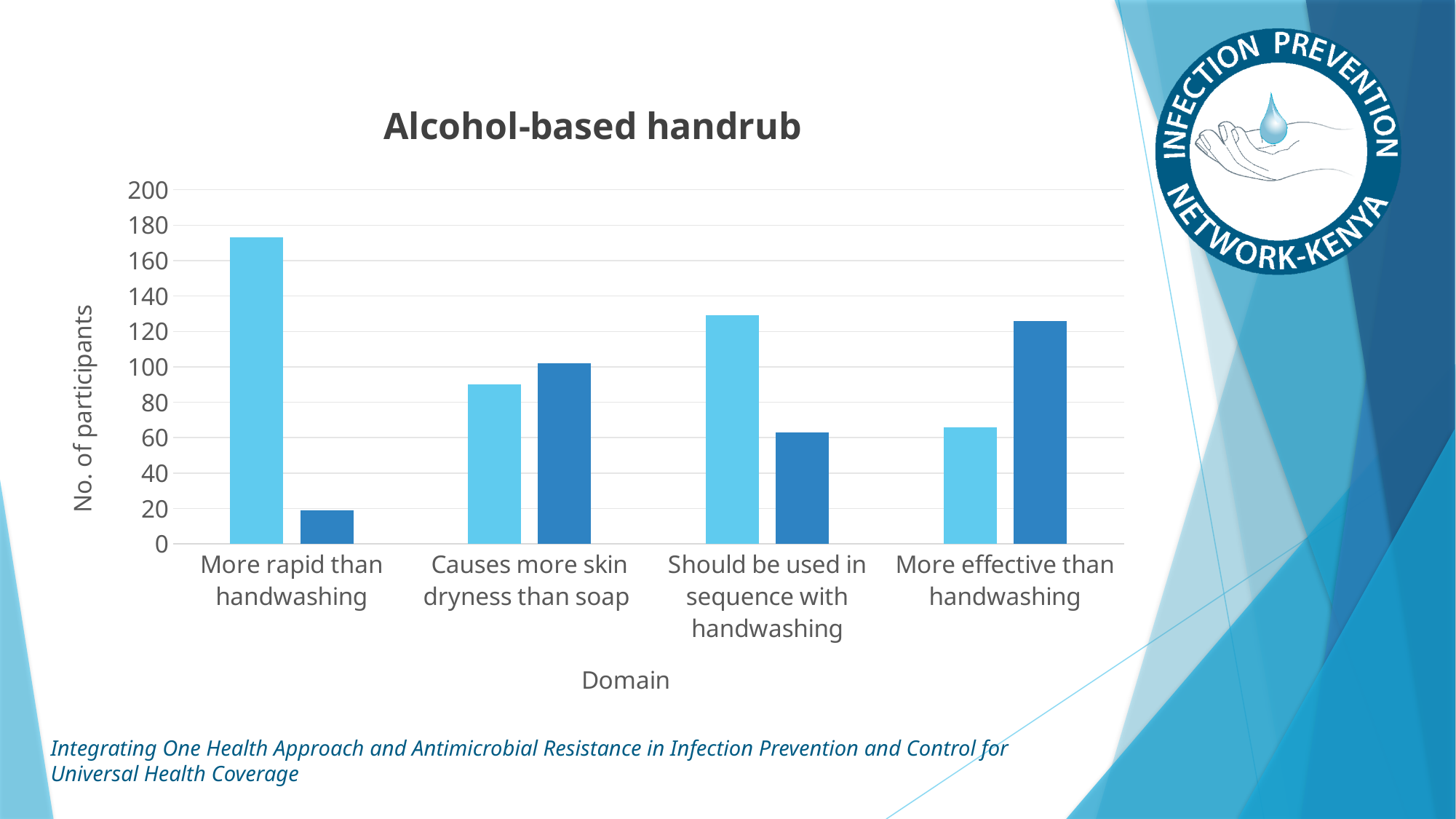
What is the title of the chart? Alcohol-based handrub For "Should be used in sequence with handwashing", which bar is taller, the light blue or the dark blue one? Light blue Is the dark blue bar for "More effective than handwashing" greater or less than 100? greater How many domain categories are shown on the x axis of the chart? 4 What is the label of the vertical axis of the chart? No. of participants Which category has the tallest light blue bar? More rapid than handwashing For "Causes more skin dryness than soap", which bar is taller, the light blue or the dark blue one? Dark blue What kind of chart is shown on the slide? Bar chart Is the light blue bar for "More rapid than handwashing" greater or less than 160? greater Which category has the shortest dark blue bar? More rapid than handwashing Is the dark blue bar for "More rapid than handwashing" greater or less than 40? less